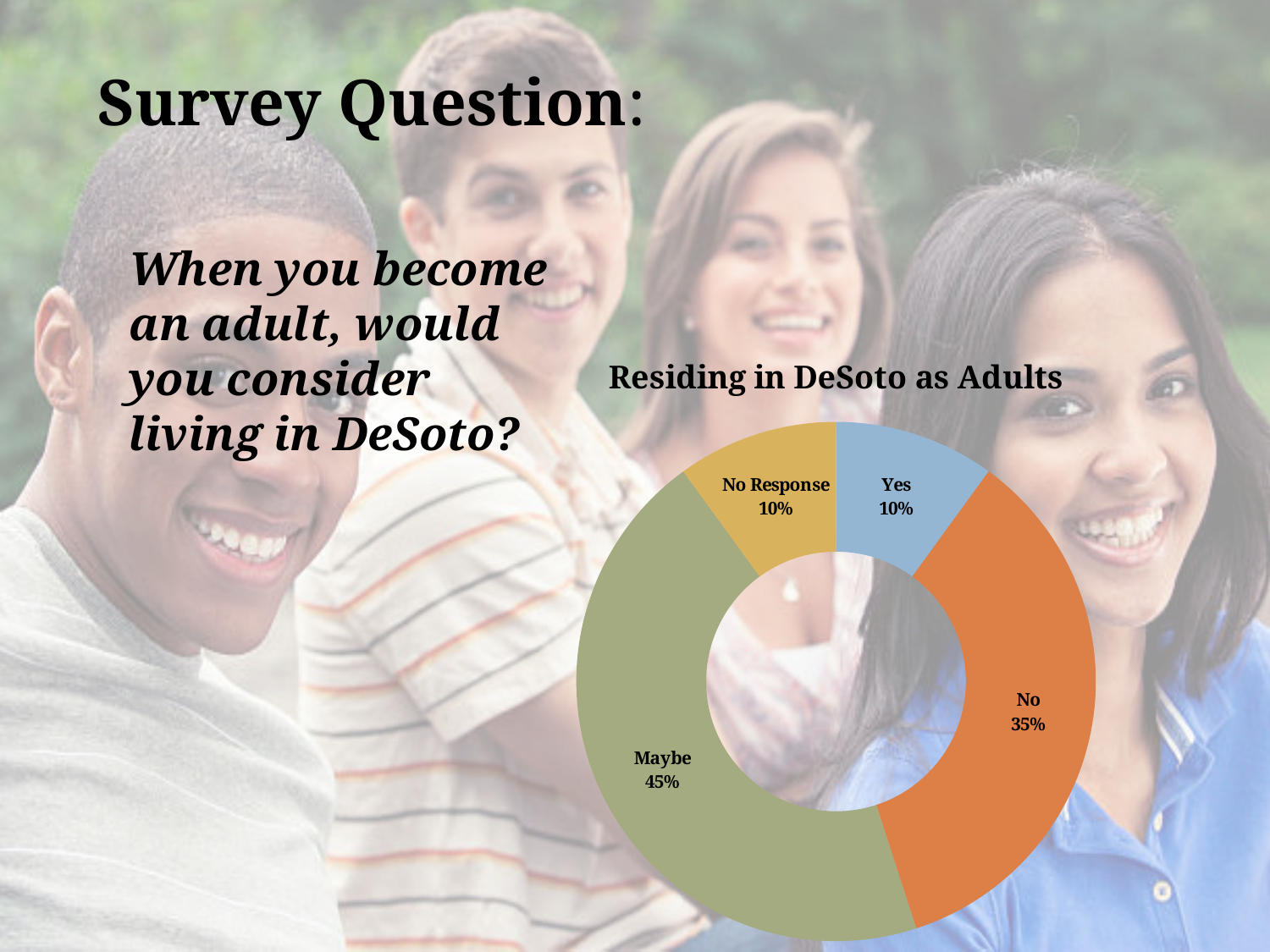
What type of chart is shown on the slide? Doughnut (pie) chart What is the title of the chart? Residing in DeSoto as Adults Which response category has the largest share? Maybe What percentage of respondents answered "Maybe" in the Residing in DeSoto as Adults chart? 45% What is the combined percentage of the "Yes" and "No Response" slices? 20% What colour is the "No" slice? Orange What is the difference in percentage points between the "Maybe" and "No" slices? 10 What percentage of respondents answered "Yes"? 10% How many response categories are shown in the chart? 4 What percentage of respondents answered "No"? 35% What share of the chart is labelled "No Response"? 10% Which is larger, the "No" slice or the "Yes" slice? No